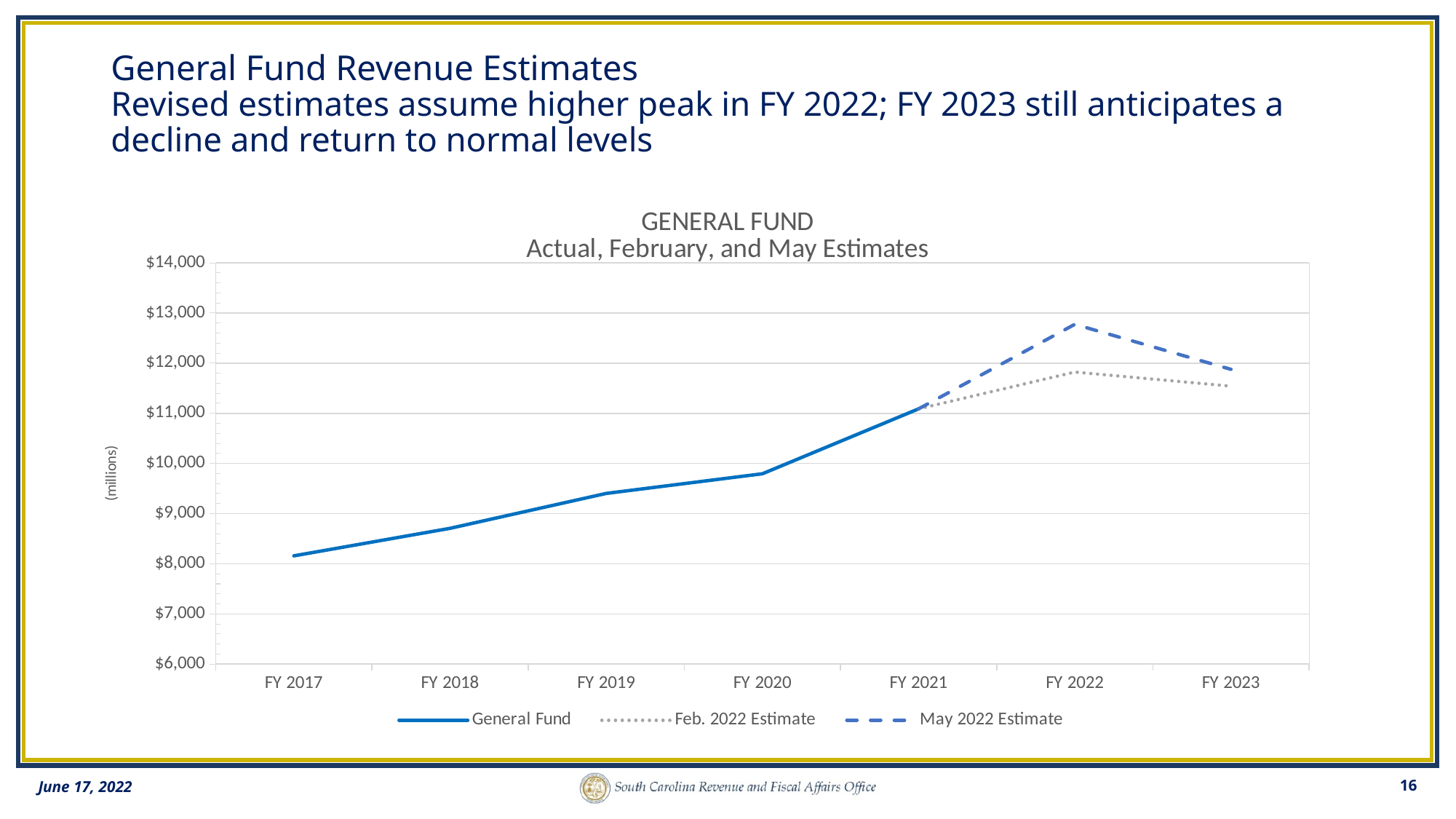
Is the General Fund value for FY 2017 greater or less than $9,000? less Does the General Fund line rise or fall from FY 2017 to FY 2021? rise How many fiscal years are shown on the x axis of the chart? 7 For FY 2022, which is higher: the Feb. 2022 Estimate or the May 2022 Estimate? May 2022 Estimate In which fiscal year does the May 2022 Estimate reach its highest value? FY 2022 What unit is shown on the y axis label of the chart? (millions) Is the General Fund value for FY 2020 greater or less than $10,000? less Is the Feb. 2022 Estimate for FY 2022 greater or less than $12,000? less What kind of chart is shown on the slide? line chart How many series does the chart legend list? 3